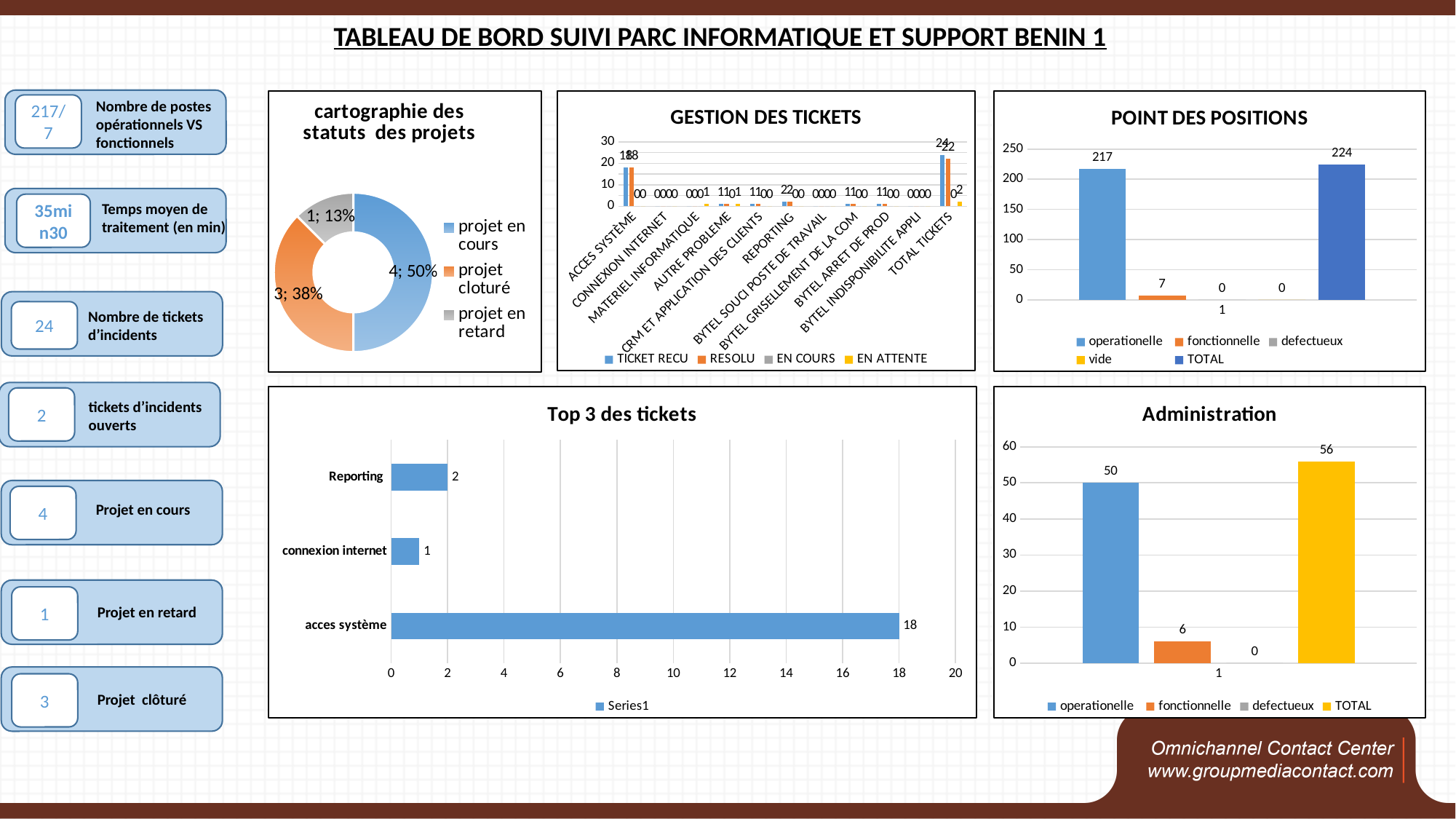
What kind of chart is 'Top 3 des tickets'? bar chart In the 'Top 3 des tickets' chart, what is the difference between acces système and Reporting? 16 In the 'cartographie des statuts des projets' chart, which category has the largest share? projet en cours In the 'Top 3 des tickets' chart, what is the value for acces système? 18 In the 'cartographie des statuts des projets' chart, how many categories are shown? 3 In the 'Administration' chart, which is larger, operationelle or fonctionnelle? operationelle In the 'POINT DES POSITIONS' chart, what is the value for operationelle? 217 In the 'POINT DES POSITIONS' chart, what is the difference between TOTAL and operationelle? 7 How many series does the legend of the 'Administration' chart list? 4 In the 'Top 3 des tickets' chart, which category has the lowest value? connexion internet In the 'cartographie des statuts des projets' chart, what share of the pie is 'projet cloturé'? 38% How many series does the legend of the 'GESTION DES TICKETS' chart list? 4